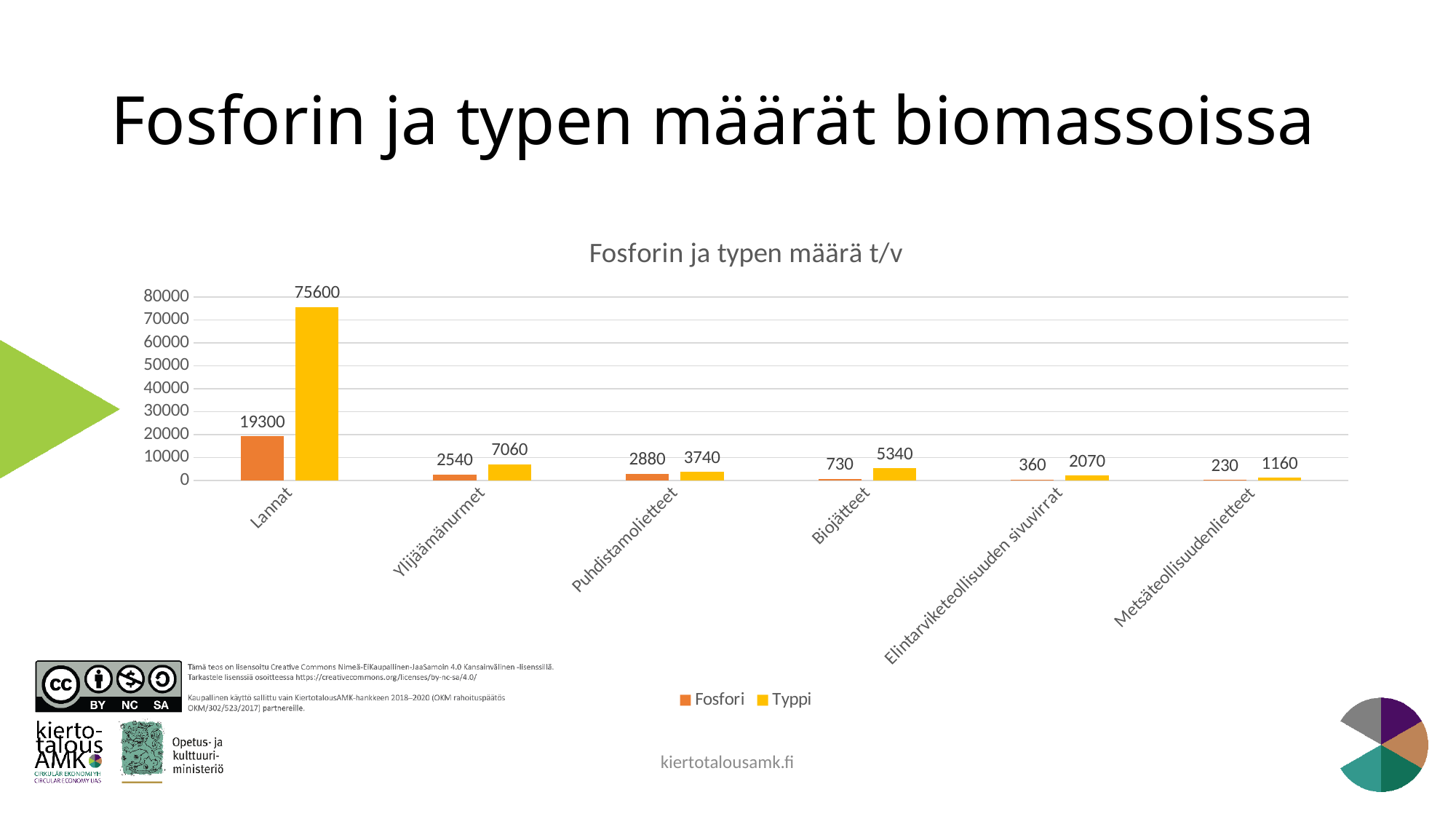
What is the difference between the Typpi and Fosfori values for Lannat? 56300 What is the Typpi value for Lannat? 75600 Which is larger, the Typpi value for Ylijäämänurmet or the Typpi value for Biojätteet? Ylijäämänurmet Which category has the lowest Typpi value? Metsäteollisuudenlietteet Which category has the highest Fosfori value? Lannat What is the Typpi value for Biojätteet? 5340 How many categories are shown on the x axis? 6 What is the Fosfori value for Puhdistamolietteet? 2880 How many series does the legend list? 2 What kind of chart is shown on the slide? Bar chart What is the title of the chart? Fosforin ja typen määrä t/v What is the Fosfori value for Metsäteollisuudenlietteet? 230